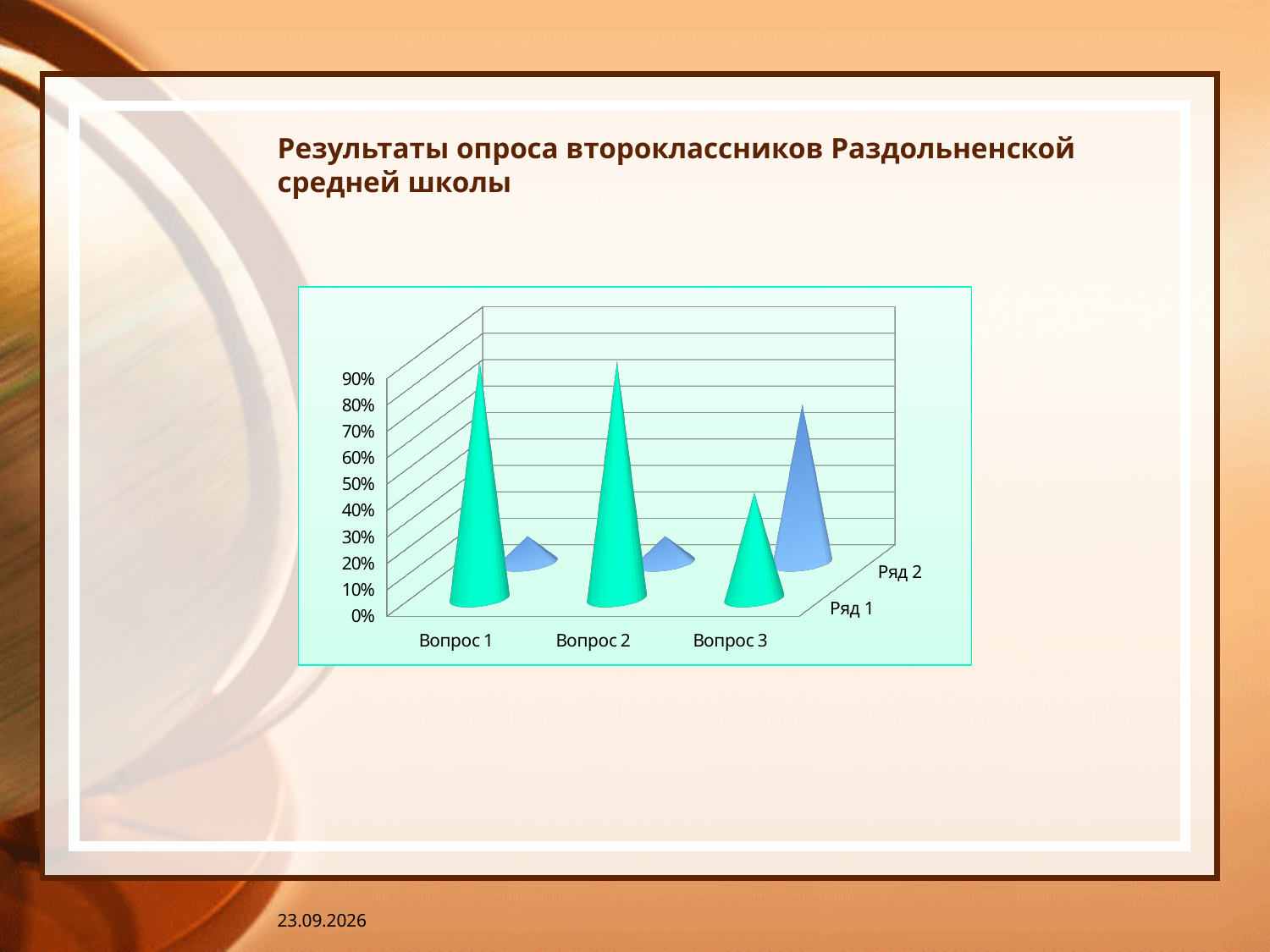
For Вопрос 3, which series has the larger value, Ряд 1 or Ряд 2? Ряд 2 For which category is the value of Ряд 2 the highest? Вопрос 3 Is the value for Ряд 1 at Вопрос 1 greater or less than 50%? greater What is the title of the slide containing the chart? Результаты опроса второклассников Раздольненской средней школы How many series does the chart show? 2 How many categories are shown on the x axis of the chart? 3 For which category is the value of Ряд 1 the lowest? Вопрос 3 What kind of chart is shown on the slide? bar chart For Вопрос 1, which series has the larger value, Ряд 1 or Ряд 2? Ряд 1 What are the names of the two series in the chart? Ряд 1 and Ряд 2 Is the value for Ряд 2 at Вопрос 2 greater or less than 30%? less Is the value for Ряд 1 at Вопрос 3 greater or less than 70%? less